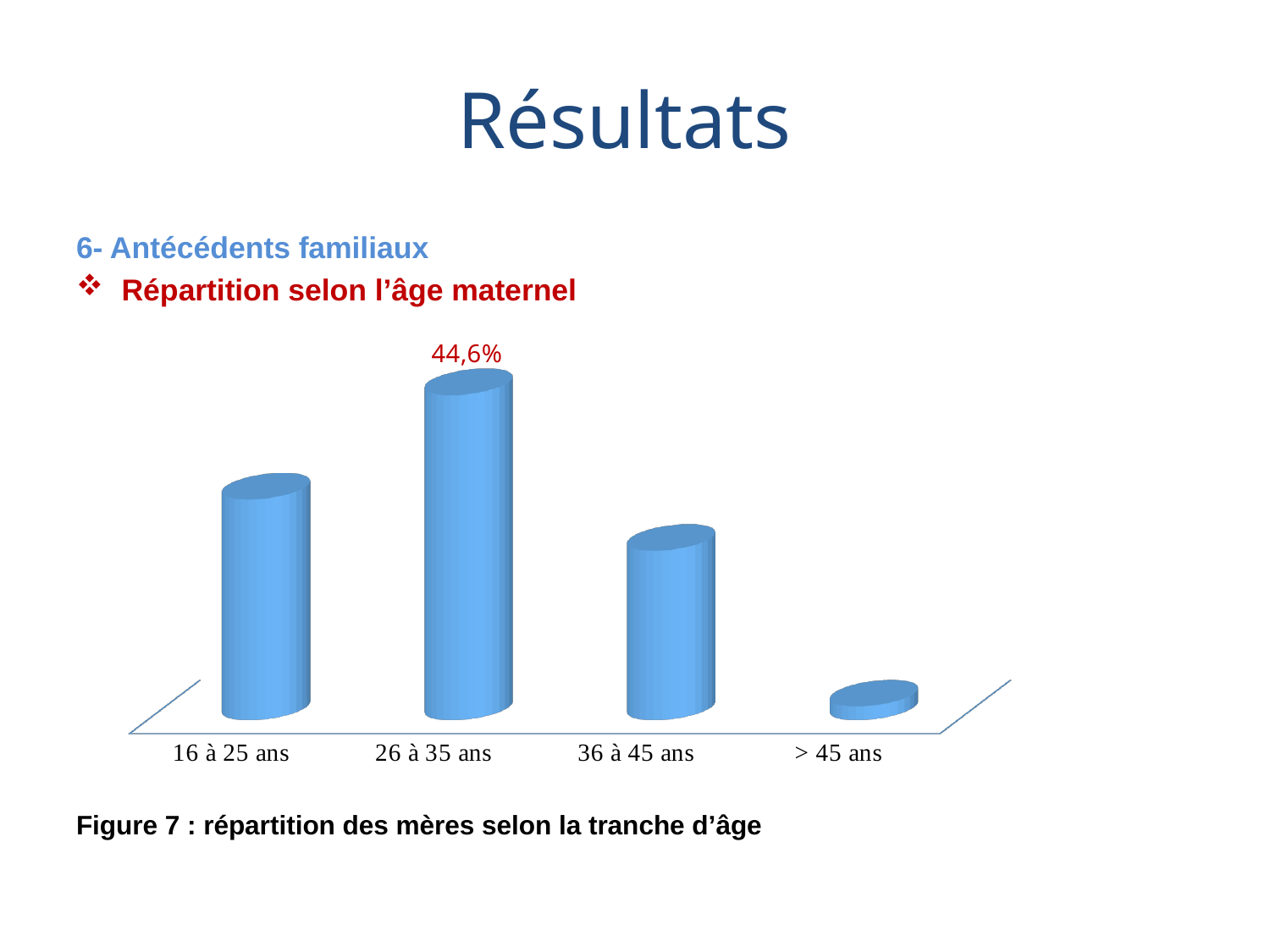
Do the values rise or fall from 26 à 35 ans to > 45 ans? Fall What value is shown for the 26 à 35 ans category? 44,6% What colour are the bars in the chart? Blue Which is larger, the bar for 16 à 25 ans or the bar for 36 à 45 ans? 16 à 25 ans Which age group has the highest bar? 26 à 35 ans What kind of chart is shown on the slide? Bar chart How many age categories are shown on the x axis? 4 Do the values rise or fall from 16 à 25 ans to 26 à 35 ans? Rise Which is larger, the bar for 36 à 45 ans or the bar for > 45 ans? 36 à 45 ans Which age group has the lowest bar? > 45 ans What is the figure caption below the chart? Figure 7 : répartition des mères selon la tranche d'âge